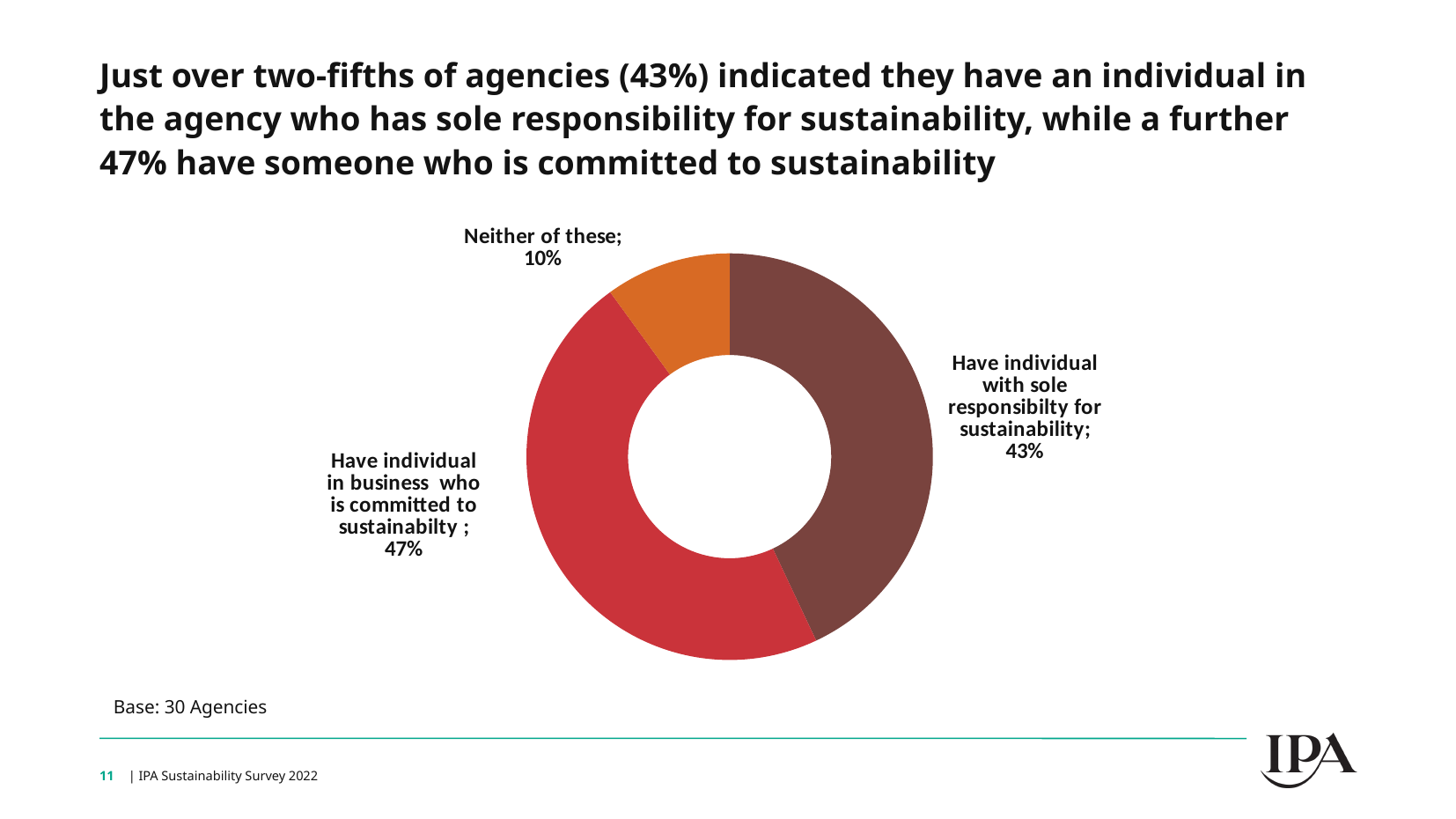
Which is larger: the share for 'Have individual with sole responsibilty for sustainability' or the share for 'Neither of these'? Have individual with sole responsibilty for sustainability What is the difference in percentage points between 'Have individual with sole responsibilty for sustainability' and 'Neither of these'? 33 percentage points What is the difference in percentage points between 'Have individual in business who is committed to sustainabilty' and 'Have individual with sole responsibilty for sustainability'? 4 percentage points What kind of chart is shown on the slide? Doughnut (pie) chart Which category has the smallest share of the chart? Neither of these What percentage of agencies answered 'Neither of these'? 10% What percentage of agencies have an individual in the business who is committed to sustainability? 47% What percentage of agencies have an individual with sole responsibility for sustainability? 43% How many categories are shown in the chart? 3 Which category has the largest share of the chart? Have individual in business who is committed to sustainabilty What colour is the 'Neither of these' slice? Orange What is the base (number of agencies) stated for the chart? 30 Agencies